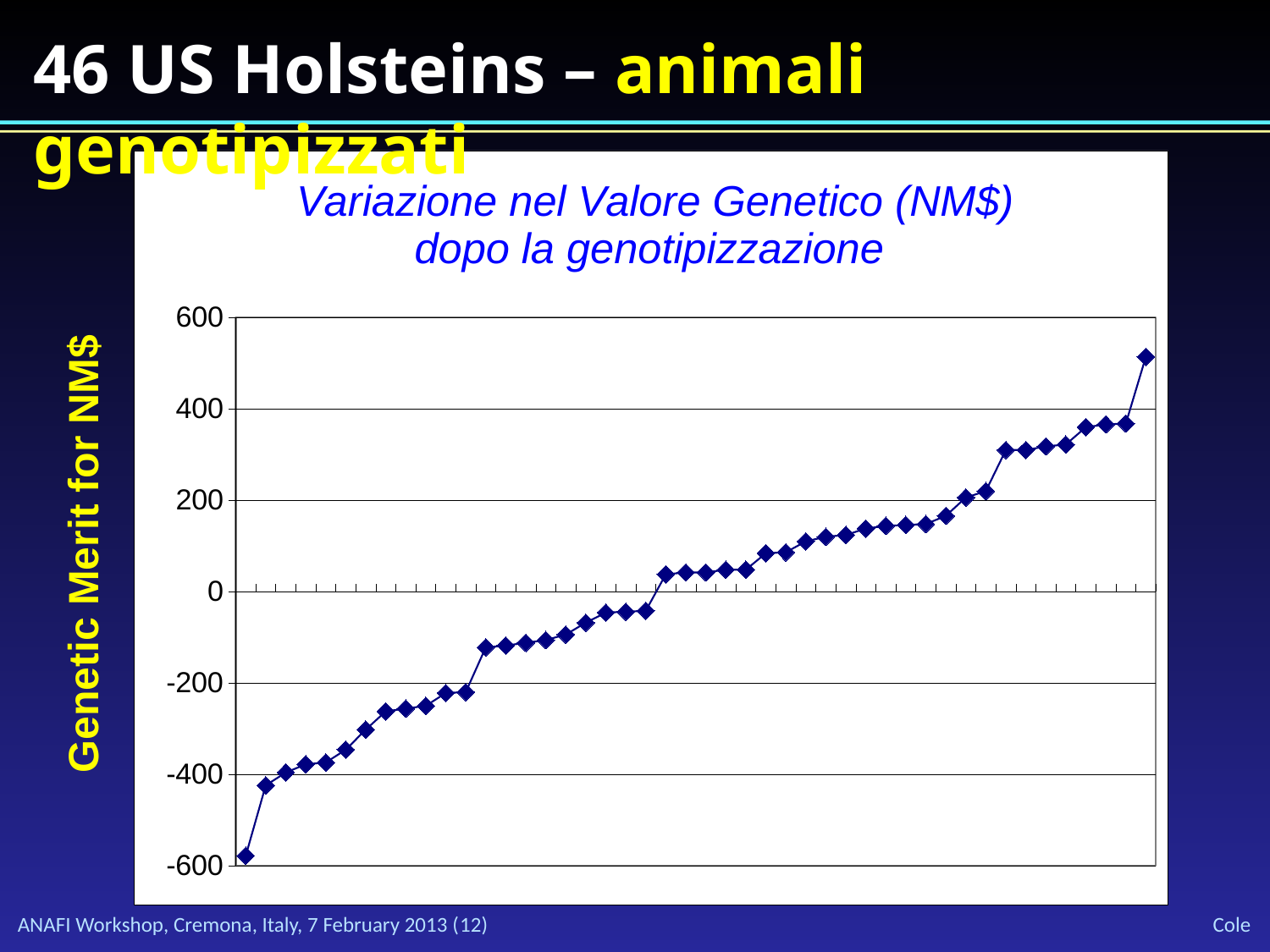
Do the plotted values rise or fall from left to right along the x axis? rise Is the value of the rightmost point greater or less than 400? greater What is the label on the vertical axis of the chart? Genetic Merit for NM$ Which point has the highest value, the leftmost or the rightmost? rightmost How many animals (data points) does the slide say are plotted? 46 What kind of chart is shown on the slide? line chart Which point has the lowest value, the leftmost or the rightmost? leftmost What is the title of the chart? Variazione nel Valore Genetico (NM$) dopo la genotipizzazione Is the value of the second point from the left greater or less than -400? less What is the highest tick value shown on the vertical axis? 600 Is the value of the leftmost point greater or less than -400? less Which is larger, the value of the leftmost point or the value of the rightmost point? rightmost